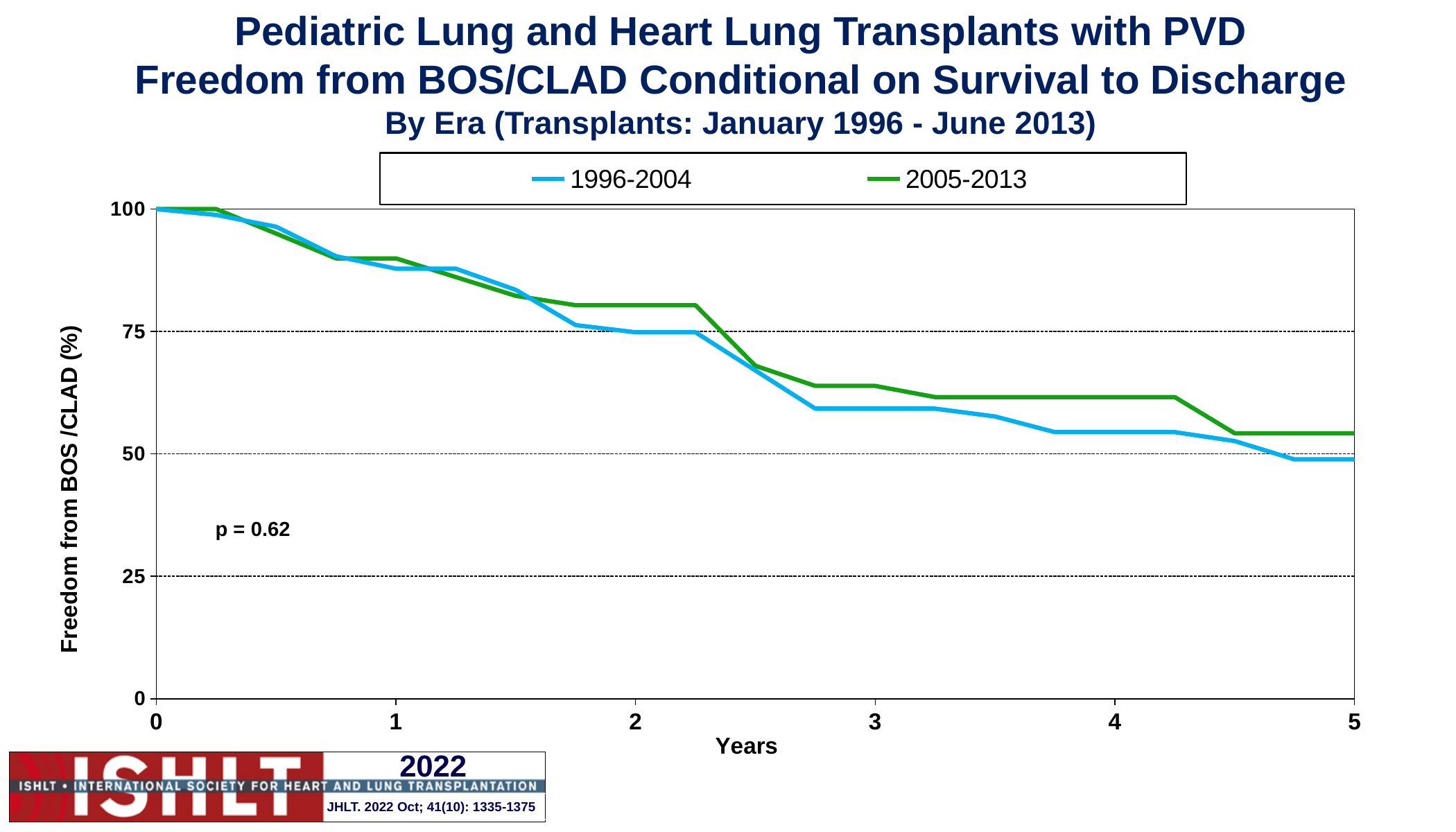
At year 5, which series has the higher freedom from BOS/CLAD, 1996-2004 or 2005-2013? 2005-2013 What are the two eras listed in the legend? 1996-2004 and 2005-2013 What kind of chart is shown on the slide? line chart Is the value for the 1996-2004 series at year 3 greater or less than 75? less How many series does the legend list? 2 What is the freedom from BOS/CLAD value for the 2005-2013 series at year 0? 100 Is the value for the 2005-2013 series at year 2 greater or less than 75? greater What p-value is printed on the chart? p = 0.62 What is the freedom from BOS/CLAD value for the 1996-2004 series at year 0? 100 Do the freedom from BOS/CLAD values rise or fall as years increase? fall At year 4, which series has the higher freedom from BOS/CLAD, 1996-2004 or 2005-2013? 2005-2013 Is the value for the 2005-2013 series at year 5 greater or less than 50? greater